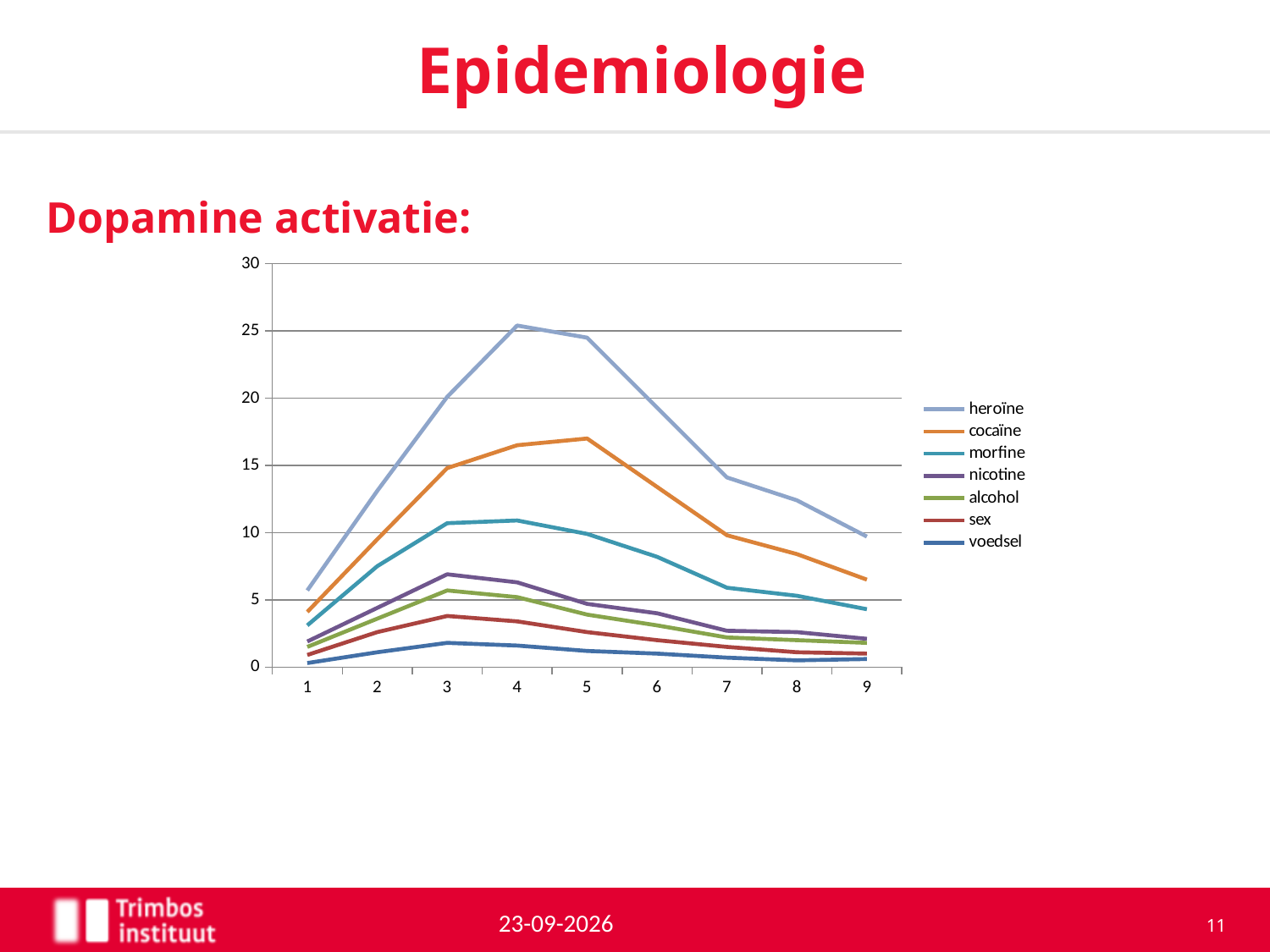
Does the heroïne line rise or fall from point 5 to point 9? fall Which series reaches the highest value on the chart? heroïne Which series is drawn in orange? cocaïne How many series does the legend list? 7 At point 4, which is larger: heroïne or cocaïne? heroïne How many points are there along the x axis? 9 What kind of chart is shown on the slide? line chart Is the value for morfine at point 4 greater or less than 15? less